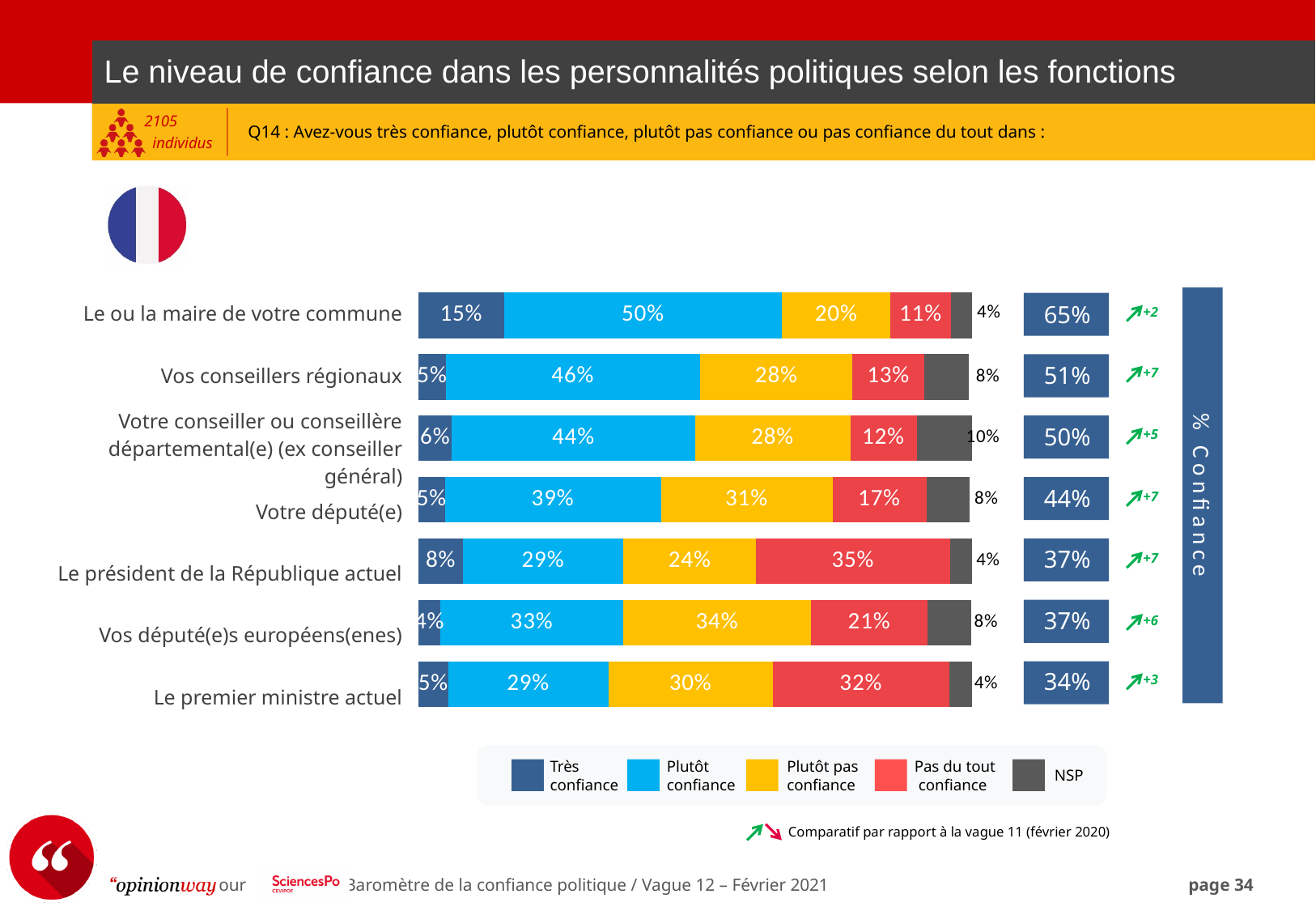
What is the change versus the previous wave shown next to the "% Confiance" figure for "Vos conseillers régionaux"? +7 What is the NSP value for "Votre conseiller ou conseillère départemental(e) (ex conseiller général)"? 10% What is the "% Confiance" figure shown for "Votre député(e)"? 44% How many categories (political functions) are shown in the chart? 7 What is the difference between the "Très confiance" values for "Le ou la maire de votre commune" and "Le président de la République actuel"? 7 percentage points What kind of chart is shown on the slide? Stacked bar chart What is the "Pas du tout confiance" value for "Le président de la République actuel"? 35% How many series does the legend list? 5 Which category has the lowest "% Confiance" figure? Le premier ministre actuel Which category has the highest "% Confiance" figure? Le ou la maire de votre commune Which has a larger "Plutôt pas confiance" value: "Vos député(e)s européens(enes)" or "Le président de la République actuel"? Vos député(e)s européens(enes) What percentage of respondents have "Plutôt confiance" in "Le ou la maire de votre commune"? 50%